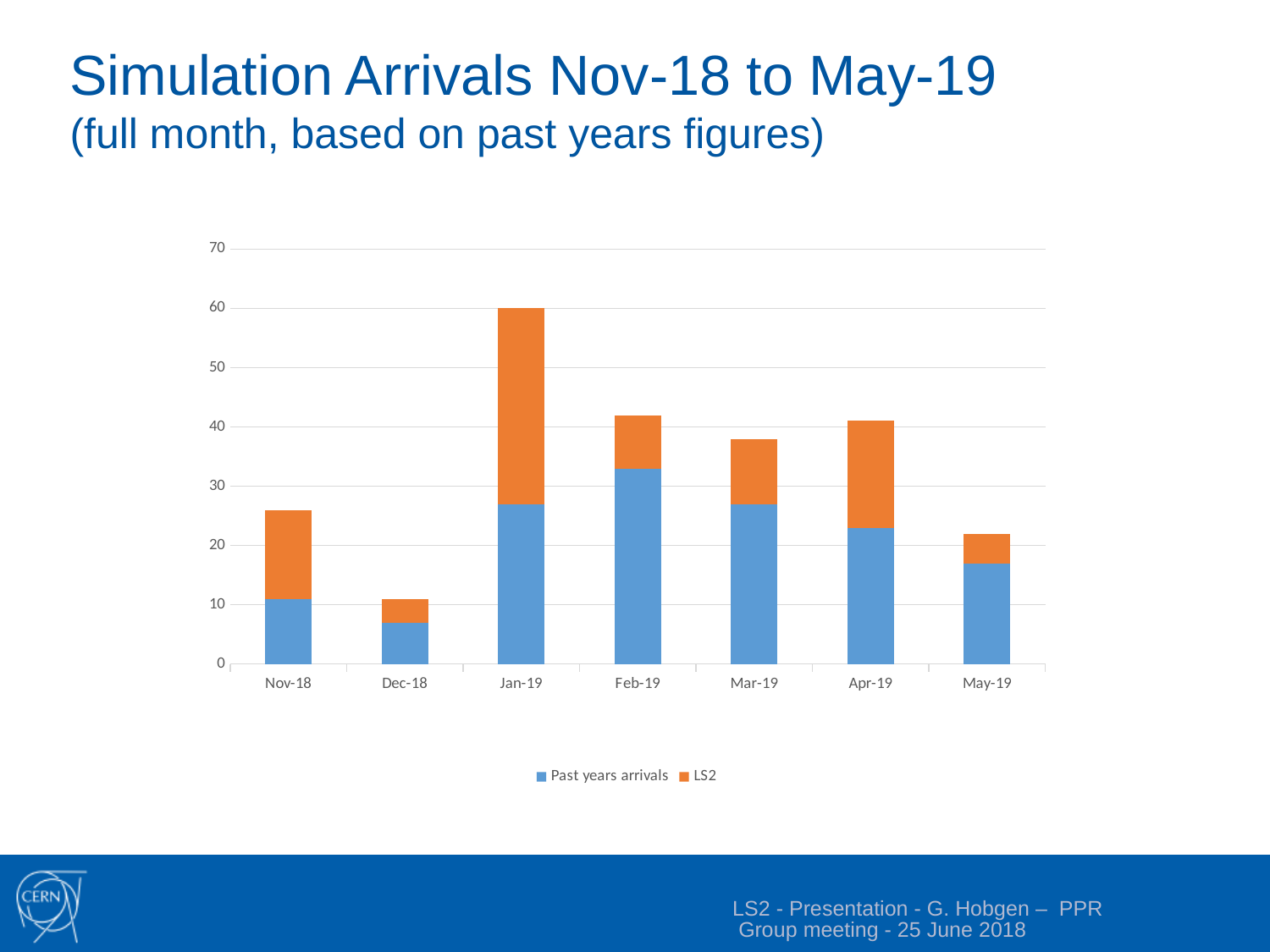
Is the total bar for Feb-19 greater or less than 40? greater Which month has the larger total bar, Feb-19 or Mar-19? Feb-19 Is the total bar for Mar-19 greater or less than 40? less Which series is shown in orange in the chart? LS2 Which month has the lowest total bar? Dec-18 Is the total bar for Dec-18 greater or less than 20? less Which month has the highest total bar? Jan-19 Which month has the larger total bar, Nov-18 or May-19? Nov-18 What kind of chart is shown on the slide? bar chart How many series does the chart's legend list? 2 How many months are shown on the x axis of the chart? 7